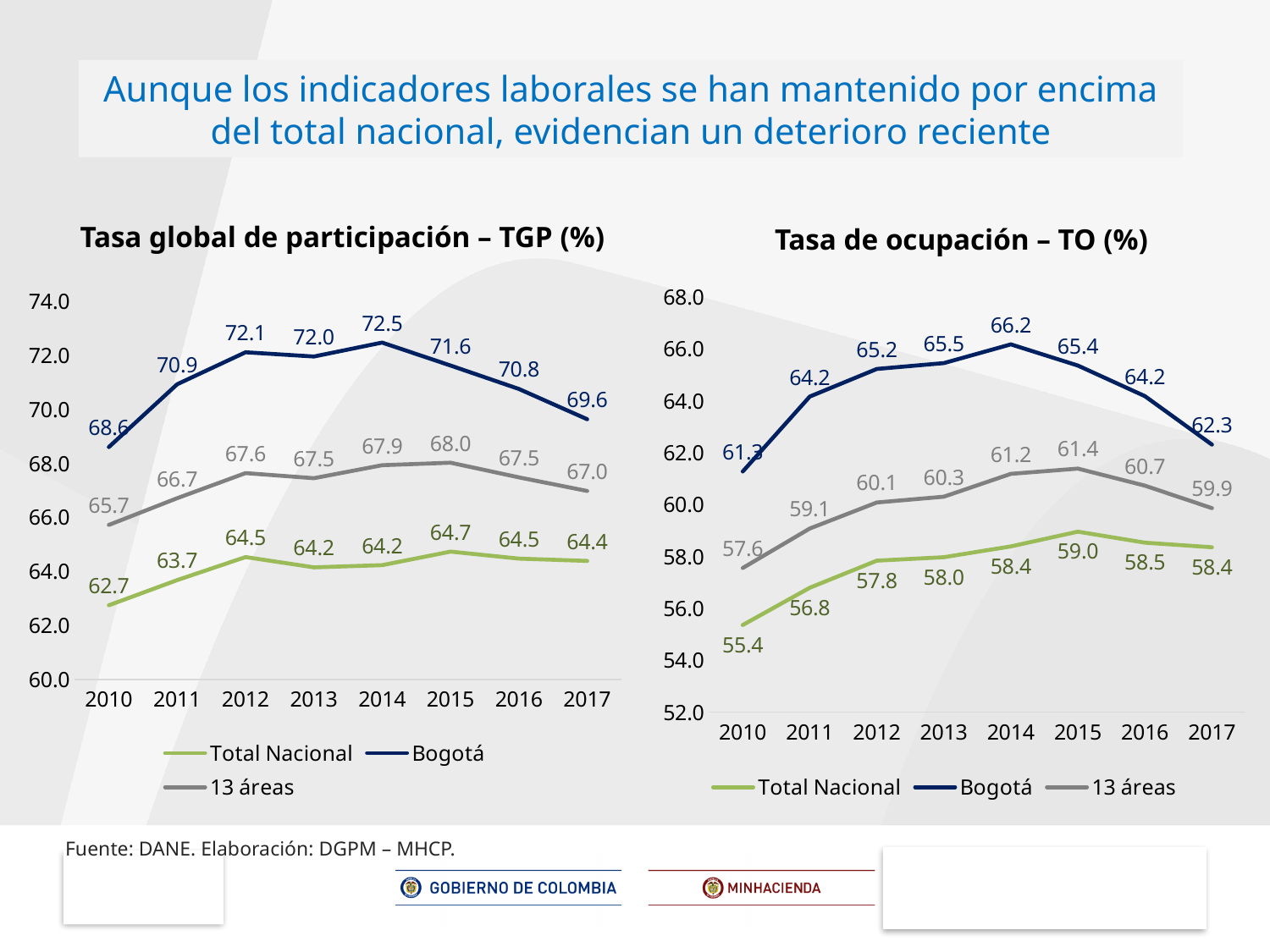
In the 'Tasa de ocupación – TO (%)' chart, does the Bogotá series rise or fall from 2014 to 2017? Fall In the 'Tasa de ocupación – TO (%)' chart, what is the difference between the Bogotá values in 2014 and 2017? 3.9 In the 'Tasa de ocupación – TO (%)' chart, what is the value for Total Nacional in 2010? 55.4 What kind of chart is the 'Tasa de ocupación – TO (%)' chart? Line chart In the 'Tasa de ocupación – TO (%)' chart, in which year is the Bogotá series lowest? 2010 In the 'Tasa global de participación – TGP (%)' chart, what is the value for Bogotá in 2014? 72.5 In the 'Tasa global de participación – TGP (%)' chart, what is the difference between Bogotá and Total Nacional in 2017? 5.2 In the 'Tasa global de participación – TGP (%)' chart, which is larger in 2012: the 13 áreas value or the Total Nacional value? 13 áreas In the 'Tasa global de participación – TGP (%)' chart, in which year does the Bogotá series reach its highest value? 2014 In the 'Tasa de ocupación – TO (%)' chart, what is the value for 13 áreas in 2015? 61.4 How many series does the legend of the 'Tasa global de participación – TGP (%)' chart list? 3 How many years are shown on the x axis of the 'Tasa de ocupación – TO (%)' chart? 8